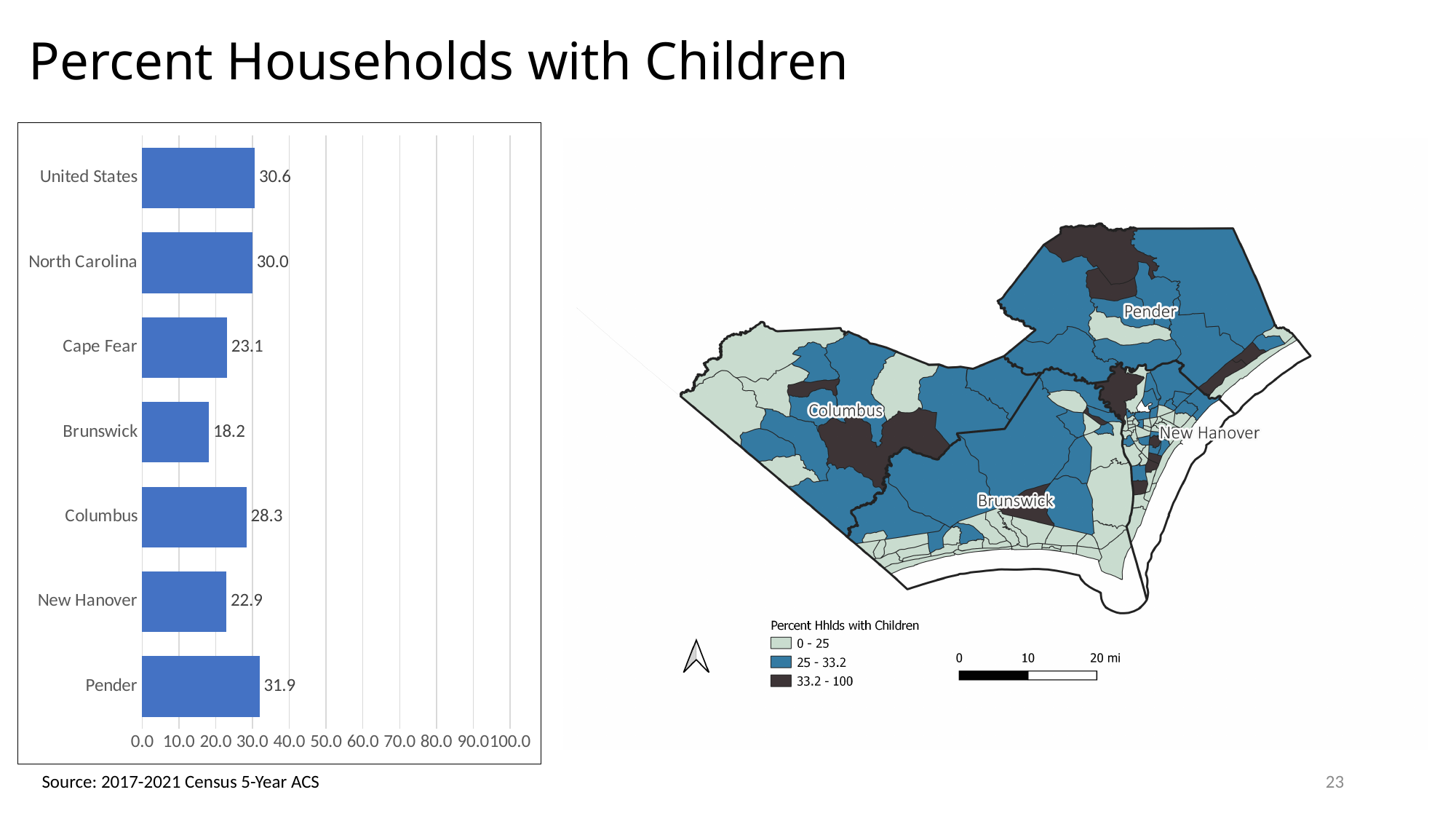
What is the difference between the values for Pender and Brunswick in the bar chart? 13.7 Which category has the highest value in the bar chart? Pender What is the highest value shown on the x axis of the bar chart? 100.0 What is the difference between the values for United States and Cape Fear in the bar chart? 7.5 Which is larger in the bar chart, Columbus or New Hanover? Columbus Is the value for Pender in the bar chart greater or less than 30.0? greater What is the value for North Carolina in the bar chart? 30.0 What is the value for Pender in the bar chart? 31.9 Which category has the lowest value in the bar chart? Brunswick What is the value for Brunswick in the bar chart? 18.2 How many categories are shown in the bar chart? 7 What kind of chart is on the left of the slide? bar chart